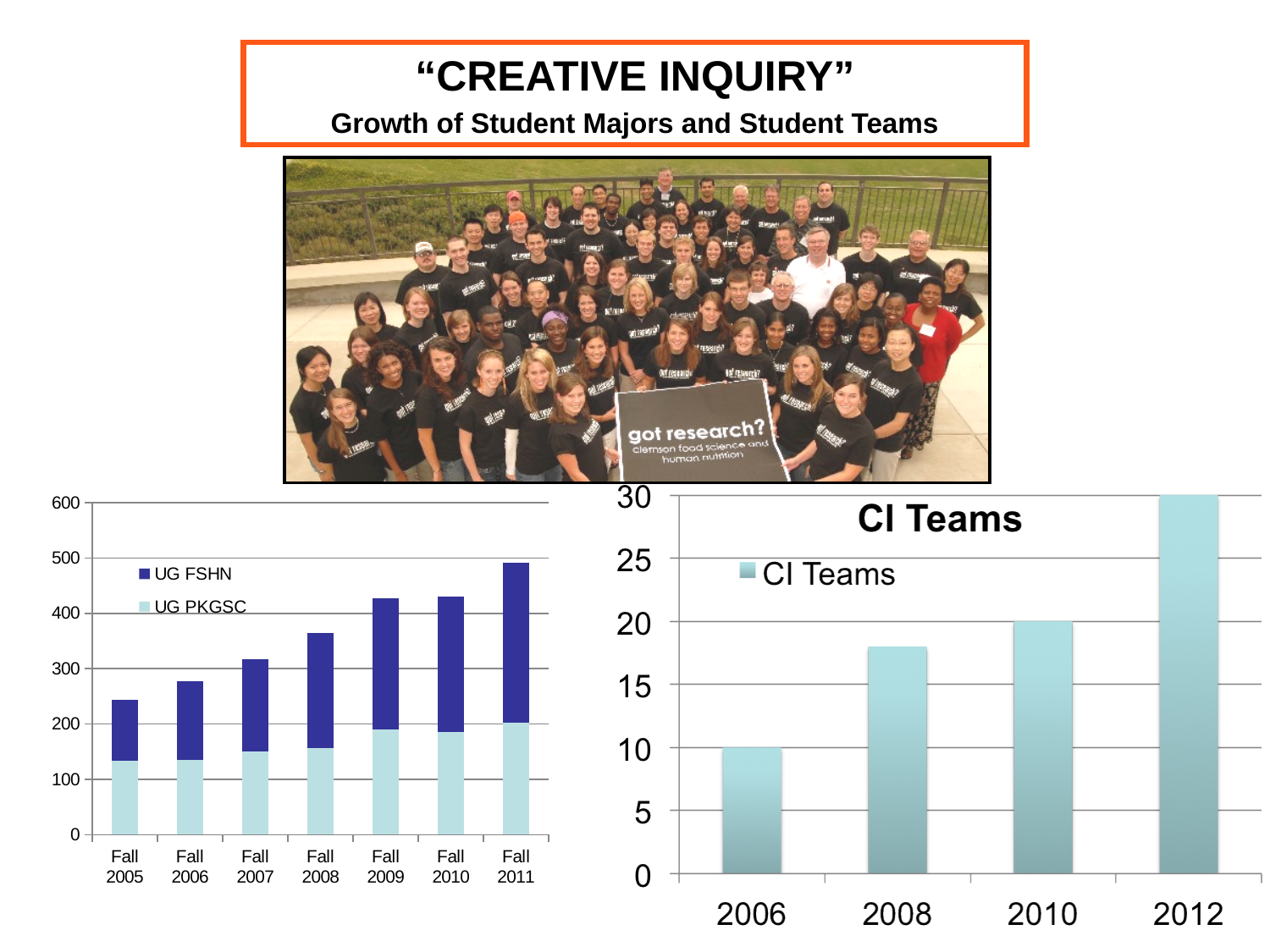
In the CI Teams chart, is the value for 2008 greater or less than 15? greater In the CI Teams chart, do the values rise or fall from 2006 to 2012? rise In the stacked bar chart on the left, is the total for Fall 2011 greater or less than 400? greater In the CI Teams chart, how many years are shown on the x axis? 4 In the stacked bar chart on the left, how many semesters are shown on the x axis? 7 In the CI Teams chart, what is the value for 2010? 20 In the stacked bar chart on the left, how many series does the legend list? 2 In the stacked bar chart on the left, which semester has the tallest total bar? Fall 2011 In the CI Teams chart, what is the value for 2012? 30 In the CI Teams chart, what is the difference between the values for 2012 and 2006? 20 In the stacked bar chart on the left, which semester has the shortest total bar? Fall 2005 In the CI Teams chart, what is the value for 2006? 10